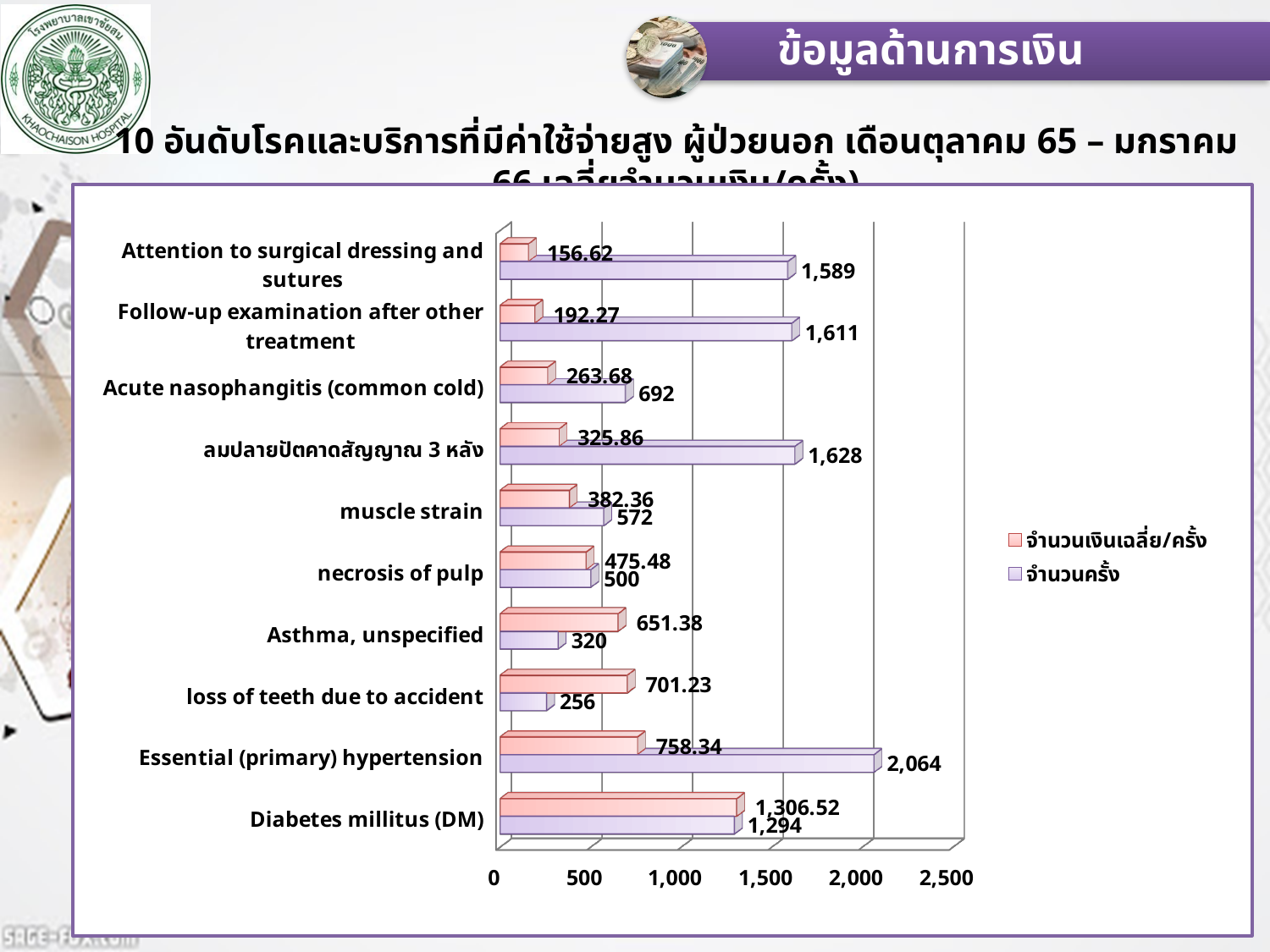
What is the จำนวนครั้ง value for Acute nasophangitis (common cold)? 692 What is the จำนวนครั้ง value for Essential (primary) hypertension? 2,064 What is the difference between the จำนวนครั้ง values for Essential (primary) hypertension and Diabetes millitus (DM)? 770 How many series does the legend list? 2 Which is larger: the จำนวนเงินเฉลี่ย/ครั้ง value for loss of teeth due to accident or for necrosis of pulp? loss of teeth due to accident What kind of chart is shown on the slide? Bar chart What is the จำนวนเงินเฉลี่ย/ครั้ง value for Asthma, unspecified? 651.38 How many categories are shown in the chart? 10 Which category has the lowest จำนวนเงินเฉลี่ย/ครั้ง value? Attention to surgical dressing and sutures Which category has the lowest จำนวนครั้ง value? loss of teeth due to accident Which category has the highest จำนวนครั้ง value? Essential (primary) hypertension What is the จำนวนเงินเฉลี่ย/ครั้ง value for Diabetes millitus (DM)? 1,306.52